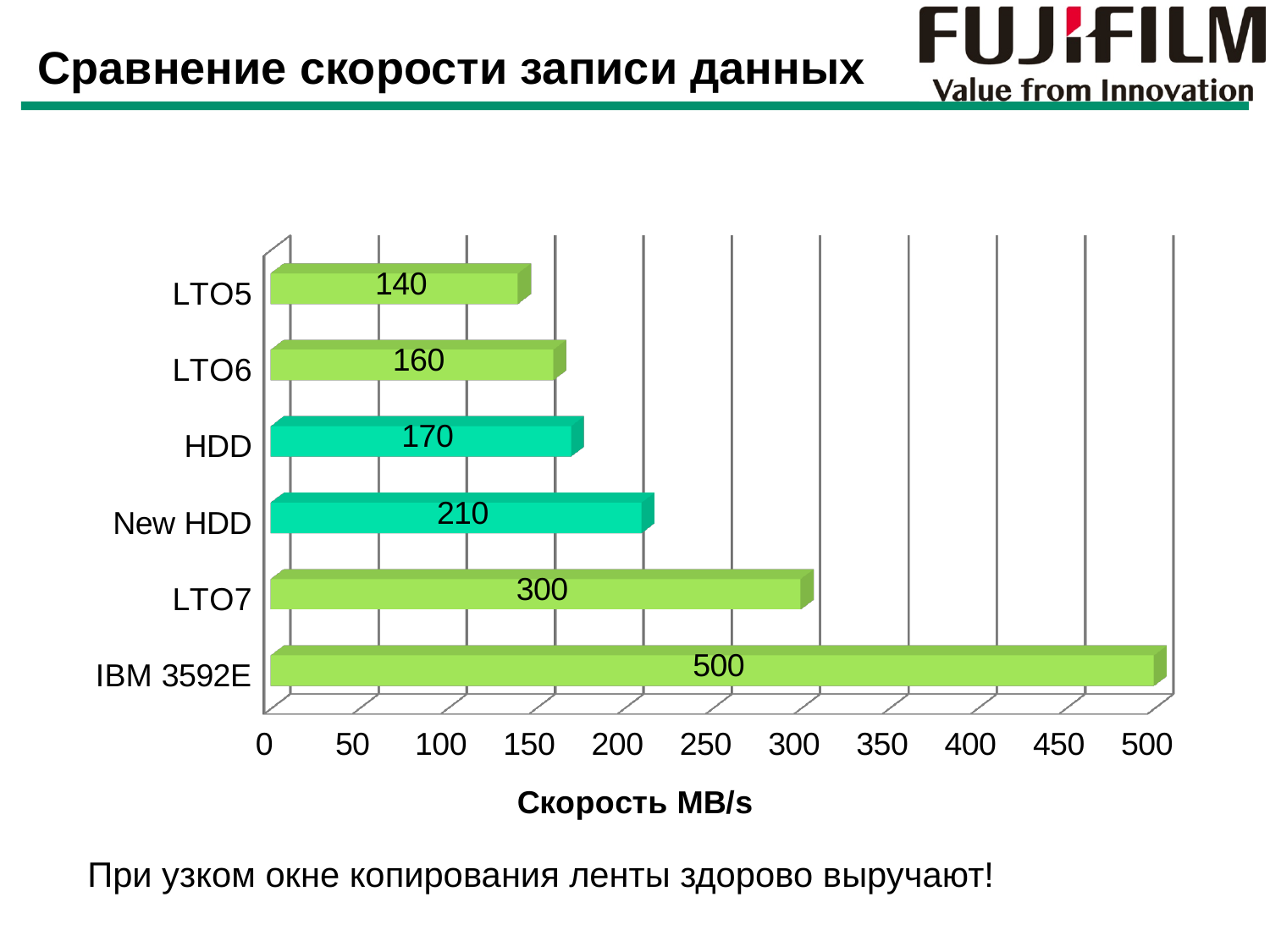
What is the value for New HDD? 210 What is the value for LTO5? 140 Which category has the highest value? IBM 3592E Which is larger, the value for New HDD or the value for HDD? New HDD What kind of chart is shown on the slide? bar chart Which category has the lowest value? LTO5 How many categories are shown in the chart? 6 What is the label of the horizontal axis? Скорость MB/s What is the value for LTO7? 300 Is the value for LTO7 greater or less than 250? greater What is the difference between the values for HDD and LTO6? 10 What is the difference between the values for IBM 3592E and LTO7? 200